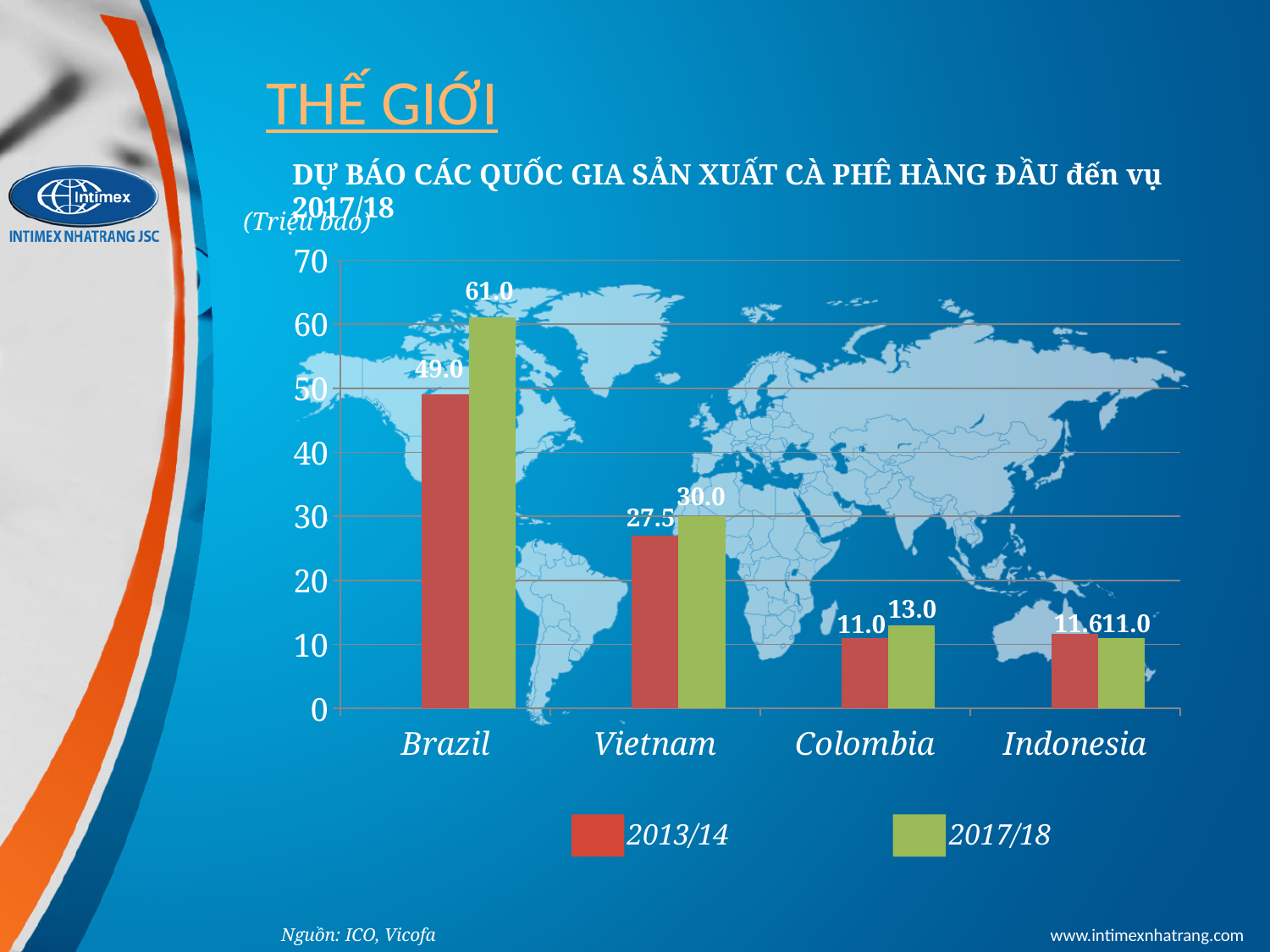
What is the value for Vietnam in the 2013/14 series? 27.5 What is the value for Colombia in the 2017/18 series? 13.0 How many series does the legend list? 2 Which country has the highest value in the 2017/18 series? Brazil Which country has the lowest value in the 2013/14 series? Colombia What is the difference between Brazil's 2017/18 value and its 2013/14 value? 12.0 How many countries are shown on the x axis? 4 Which is larger for Indonesia: the 2013/14 value or the 2017/18 value? 2013/14 What unit is given for the values in the chart? Triệu bao What kind of chart is shown on the slide? Bar chart What is the value for Indonesia in the 2013/14 series? 11.6 What is the value for Brazil in the 2017/18 series? 61.0